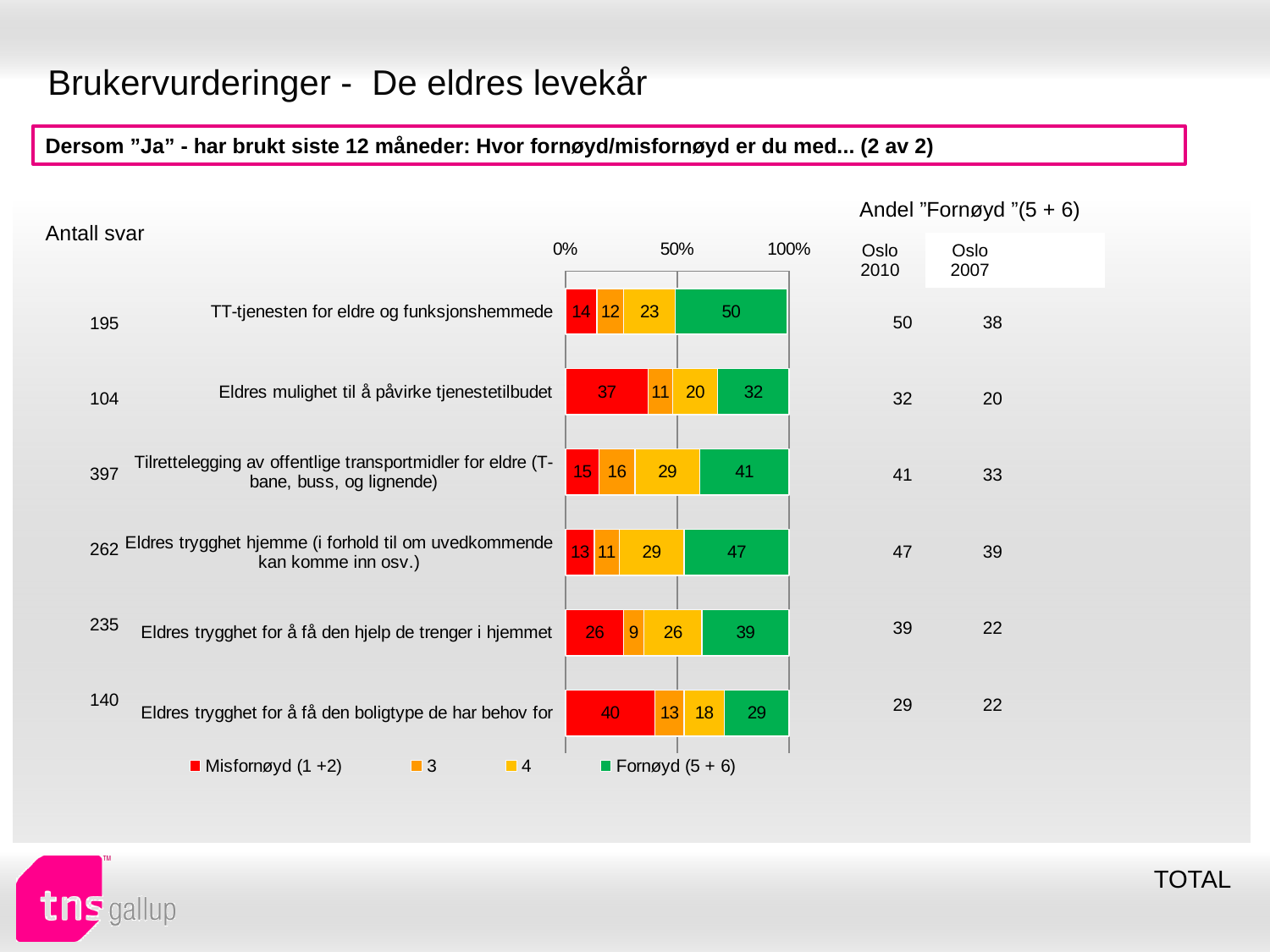
Which category has the lowest Fornøyd (5 + 6) value? Eldres trygghet for å få den boligtype de har behov for Which is larger: the Fornøyd (5 + 6) value for 'Eldres trygghet hjemme (i forhold til om uvedkommende kan komme inn osv.)' or for 'Eldres trygghet for å få den hjelp de trenger i hjemmet'? Eldres trygghet hjemme (i forhold til om uvedkommende kan komme inn osv.) What type of chart is shown on the slide? Stacked bar chart What is the difference between the Misfornøyd (1 +2) values for 'Eldres mulighet til å påvirke tjenestetilbudet' and 'Eldres trygghet hjemme (i forhold til om uvedkommende kan komme inn osv.)'? 24 What is the Fornøyd (5 + 6) value for 'TT-tjenesten for eldre og funksjonshemmede'? 50 Which category has the highest Fornøyd (5 + 6) value? TT-tjenesten for eldre og funksjonshemmede What is the total of the stacked bar for 'Eldres mulighet til å påvirke tjenestetilbudet'? 100 How many categories (rows) are plotted in the chart? 6 What is the Misfornøyd (1 +2) value for 'Eldres trygghet for å få den boligtype de har behov for'? 40 What is the value of series '3' for 'Eldres trygghet for å få den hjelp de trenger i hjemmet'? 9 What is the value of series '4' for 'Tilrettelegging av offentlige transportmidler for eldre (T-bane, buss, og lignende)'? 29 How many series does the chart legend list? 4